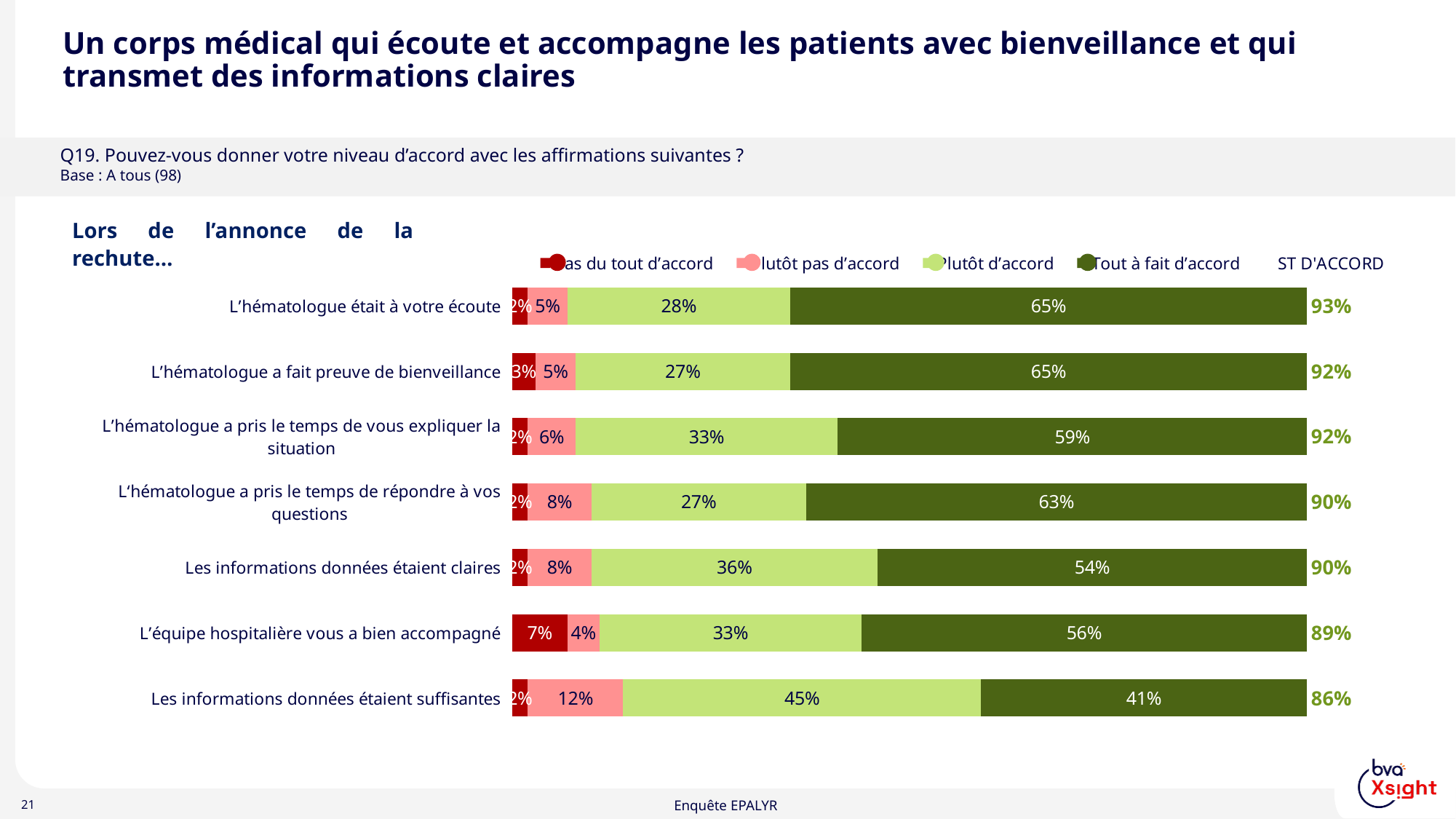
Which statement has the highest ST D'ACCORD score? L'hématologue était à votre écoute What is the difference between the 'Tout à fait d'accord' values for 'L'hématologue était à votre écoute' and 'Les informations données étaient suffisantes'? 24% What kind of chart is shown on the slide? stacked bar chart Which has a larger 'Plutôt d'accord' value: 'Les informations données étaient claires' or 'L'hématologue a fait preuve de bienveillance'? Les informations données étaient claires What is the 'Pas du tout d'accord' value for 'L'équipe hospitalière vous a bien accompagné'? 7% What is the 'Plutôt d'accord' value for 'Les informations données étaient suffisantes'? 45% What is the ST D'ACCORD score for 'L'hématologue a pris le temps de répondre à vos questions'? 90% What is the 'Plutôt pas d'accord' value for 'Les informations données étaient claires'? 8% What is the 'Tout à fait d'accord' value for 'L'hématologue était à votre écoute'? 65% Which statement has the lowest ST D'ACCORD score? Les informations données étaient suffisantes How many series does the chart legend list? 4 How many statements (categories) are plotted in the chart? 7